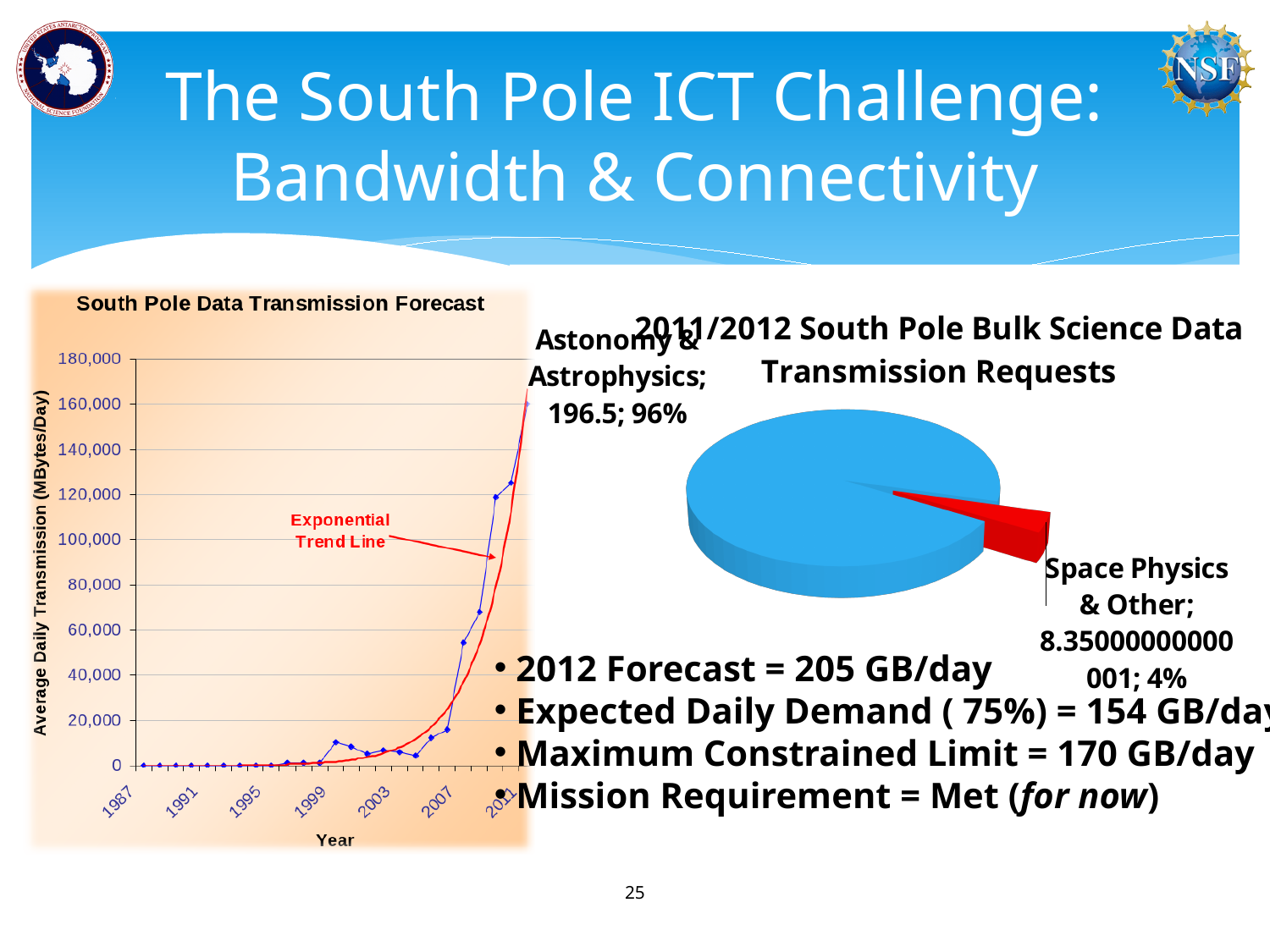
In the pie chart titled "2011/2012 South Pole Bulk Science Data Transmission Requests", what percentage share does Space Physics & Other have? 4% How many slices does the pie chart titled "2011/2012 South Pole Bulk Science Data Transmission Requests" have? 2 In the chart titled "South Pole Data Transmission Forecast", do the values generally rise or fall as the years increase? Rise In the pie chart titled "2011/2012 South Pole Bulk Science Data Transmission Requests", what is the value shown for Astronomy & Astrophysics? 196.5 What is the y-axis label of the chart titled "South Pole Data Transmission Forecast"? Average Daily Transmission (MBytes/Day) What kind of chart is the chart on the right of the slide? Pie chart In the pie chart titled "2011/2012 South Pole Bulk Science Data Transmission Requests", what percentage share does Astronomy & Astrophysics have? 96% In the chart titled "South Pole Data Transmission Forecast", is the highest plotted value greater or less than 140,000? greater In the chart titled "South Pole Data Transmission Forecast", is the value for 1995 greater or less than 20,000? less In the pie chart titled "2011/2012 South Pole Bulk Science Data Transmission Requests", which slice is the largest? Astronomy & Astrophysics In the pie chart titled "2011/2012 South Pole Bulk Science Data Transmission Requests", which slice is the smallest? Space Physics & Other What kind of chart is the chart titled "South Pole Data Transmission Forecast"? Line chart